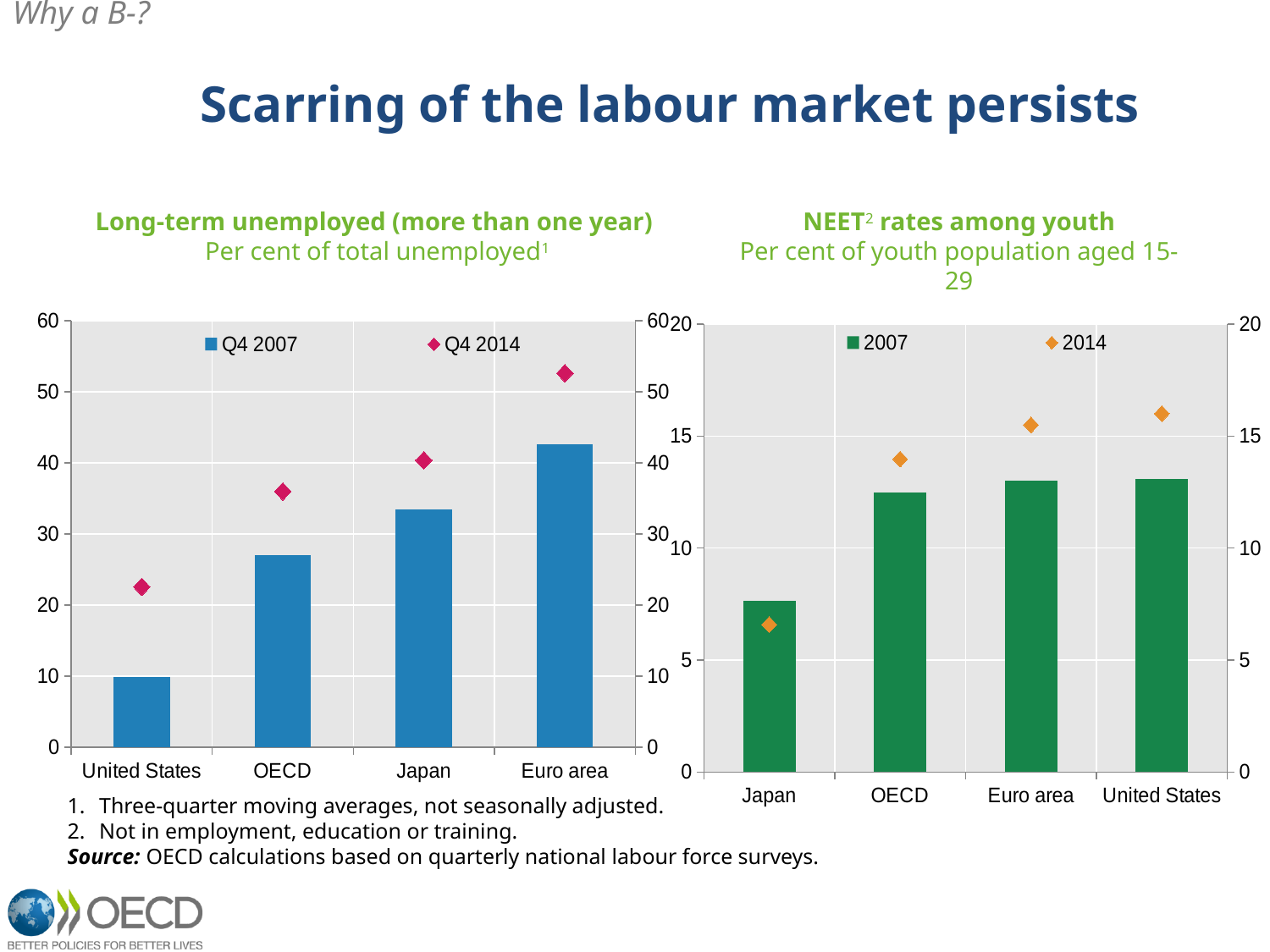
On the 'NEET rates among youth' chart, which category has the lowest 2007 value? Japan On the 'Long-term unemployed' chart, for the United States, which is larger: the Q4 2007 value or the Q4 2014 value? Q4 2014 On the 'Long-term unemployed' chart, which category has the highest Q4 2007 value? Euro area On the 'Long-term unemployed' chart, is the Q4 2007 value for Japan greater or less than 30? greater On the 'NEET rates among youth' chart, is the 2007 value for Japan greater or less than 10? less On the 'Long-term unemployed' chart, is the Q4 2014 value for the Euro area greater or less than 50? greater How many series does the legend of the 'NEET rates among youth' chart list? 2 On the 'Long-term unemployed' chart, do the Q4 2007 values rise or fall from United States to Euro area along the x axis? rise On the 'Long-term unemployed' chart, which category has the lowest Q4 2014 value? United States On the 'NEET rates among youth' chart, for Japan, which is larger: the 2007 value or the 2014 value? 2007